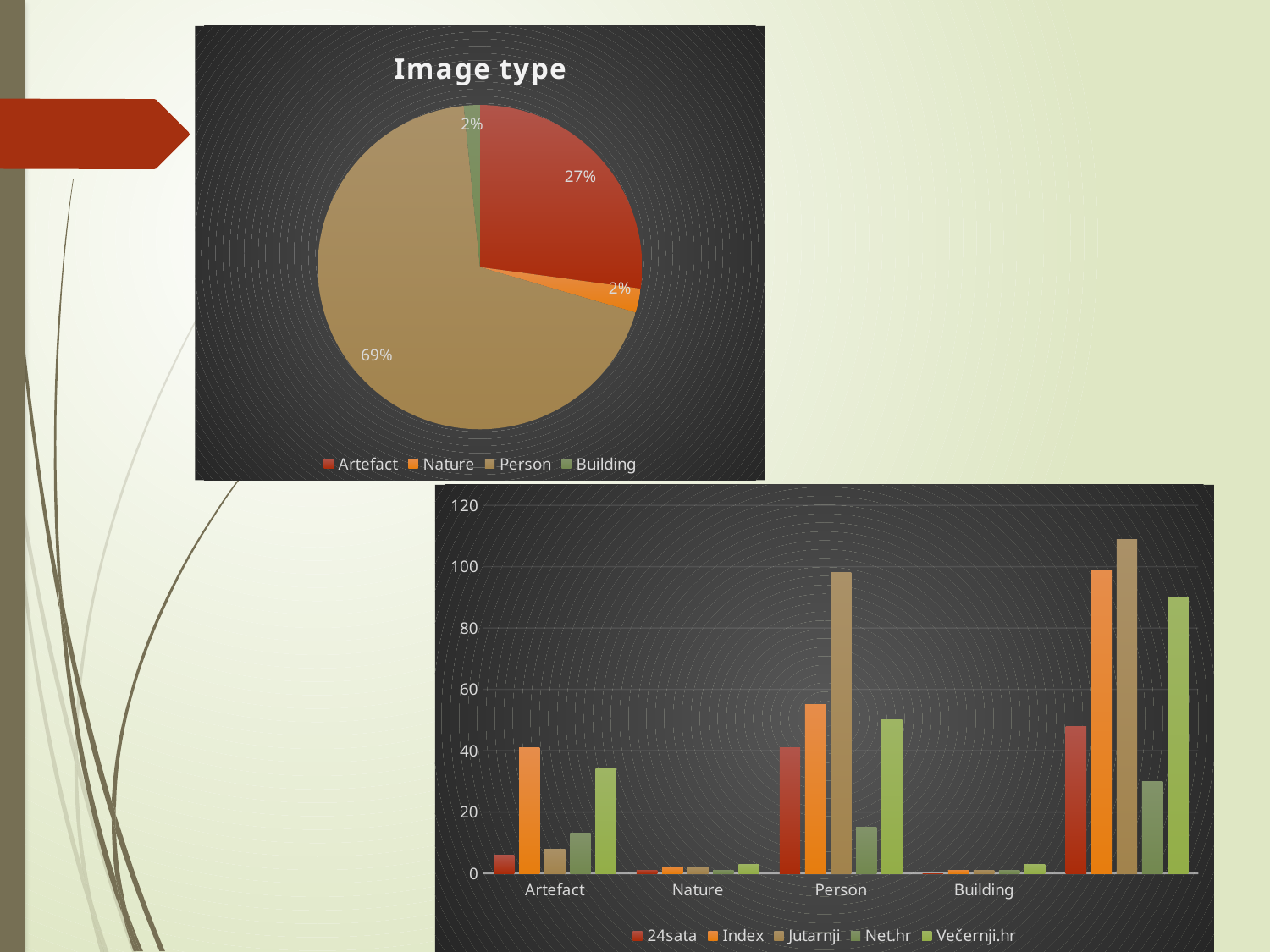
In the 'Image type' pie chart, what percentage is shown for Person? 69% In the 'Image type' pie chart, what percentage is shown for Artefact? 27% In the 'Image type' pie chart, how many percentage points larger is Person than Artefact? 42 In the bottom-right bar chart, is the value for Jutarnji in the Person category greater or less than 80? greater How many slices does the 'Image type' pie chart have? 4 In the bottom-right bar chart, which series has the tallest bar in the Person category? Jutarnji In the 'Image type' pie chart, which category has the largest slice? Person How many series does the legend of the bottom-right bar chart list? 5 In the bottom-right bar chart, is the value for Net.hr in the Person category greater or less than 20? less In the 'Image type' pie chart, which is larger, Artefact or Person? Person What kind of chart is the chart at the bottom right of the slide? Bar chart What kind of chart is the 'Image type' chart at the top of the slide? Pie chart